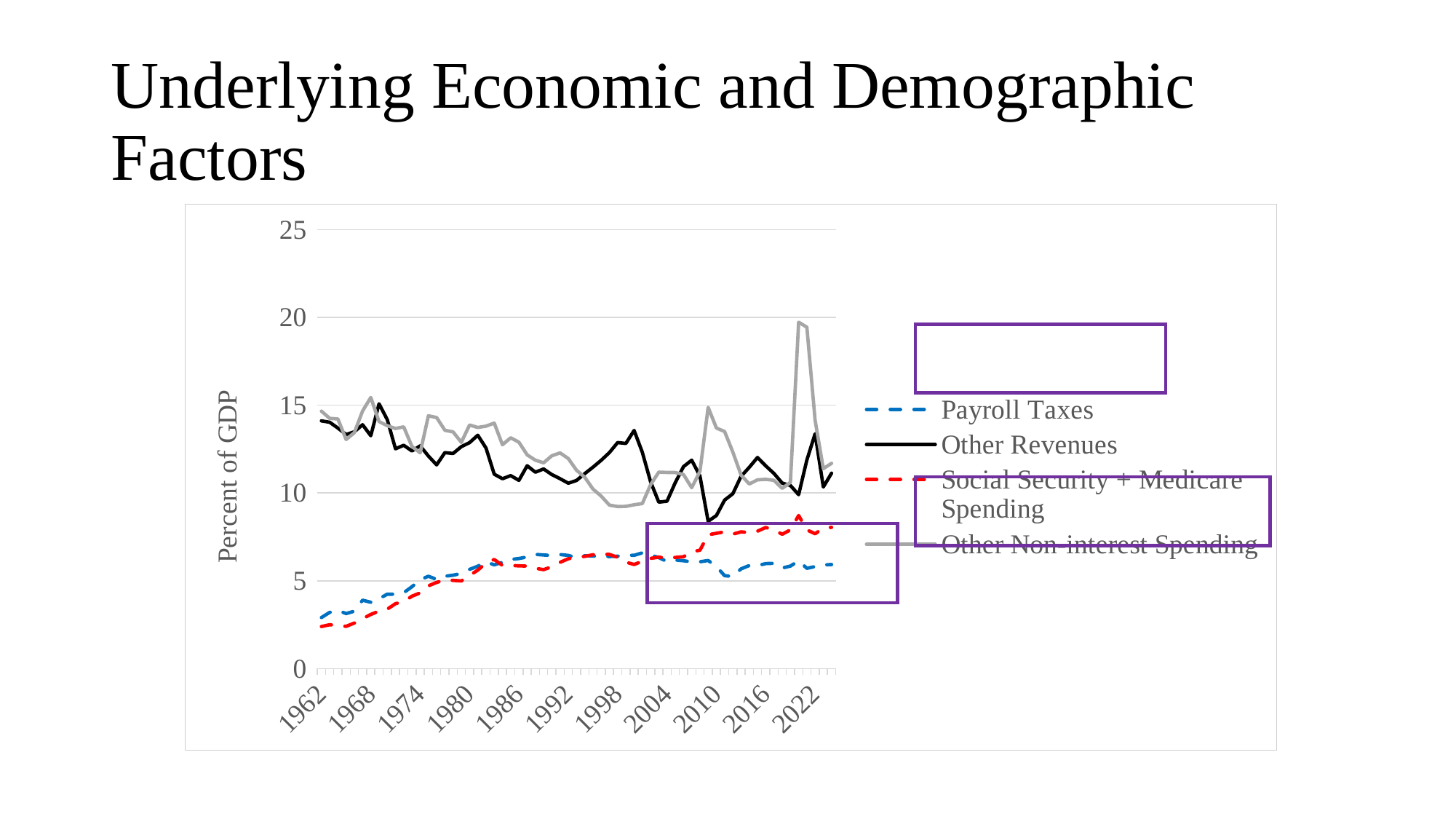
Around 2020, which is larger: Other Non-interest Spending or Other Revenues? Other Non-interest Spending How many series does the legend list? 4 Is the value for Payroll Taxes in 1962 greater or less than 5? less Is the value for Social Security + Medicare Spending at the end of the series (around 2022) greater or less than 5? greater Does Social Security + Medicare Spending generally rise or fall from 1962 to 2022? rise In 1962, which is larger: Other Revenues or Payroll Taxes? Other Revenues Which series is drawn as a solid black line? Other Revenues Is the value for Other Revenues in 1962 greater or less than 10? greater What kind of chart is shown on the slide? line chart Which series reaches the highest value anywhere on the chart? Other Non-interest Spending What is the title of the vertical axis? Percent of GDP